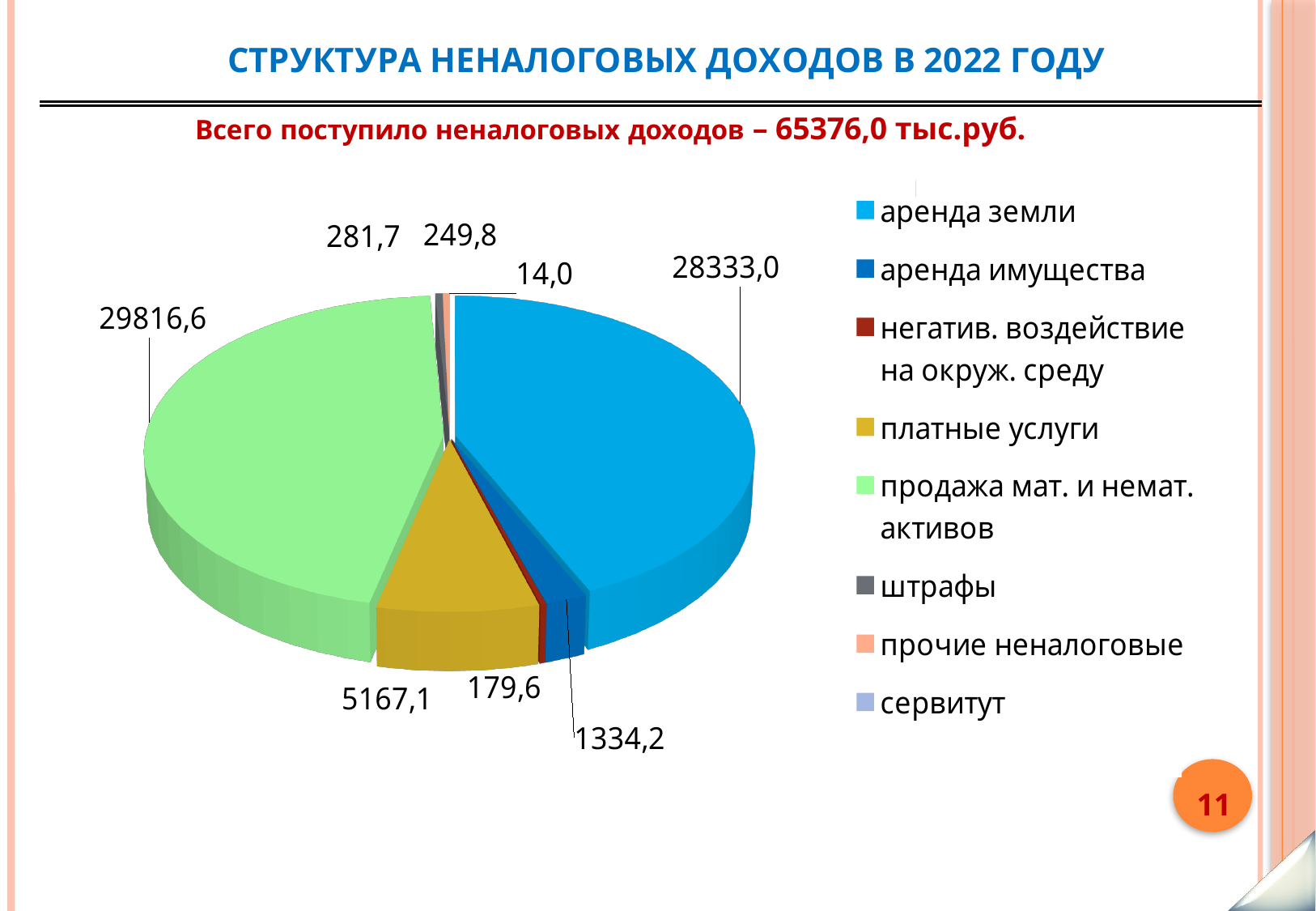
What is the value for "сервитут"? 14,0 What is the value for "штрафы"? 281,7 What is the value for "продажа мат. и немат. активов"? 29816,6 What is the value for "аренда земли"? 28333,0 How many categories does the legend list? 8 Which is larger: "платные услуги" or "аренда имущества"? платные услуги What is the value for "платные услуги"? 5167,1 What total of non-tax revenues is stated on the slide? 65376,0 тыс.руб. Which category has the smallest value? сервитут Which category has the largest value? продажа мат. и немат. активов What type of chart is shown on the slide? Pie chart What is the difference between "продажа мат. и немат. активов" and "аренда земли"? 1483,6